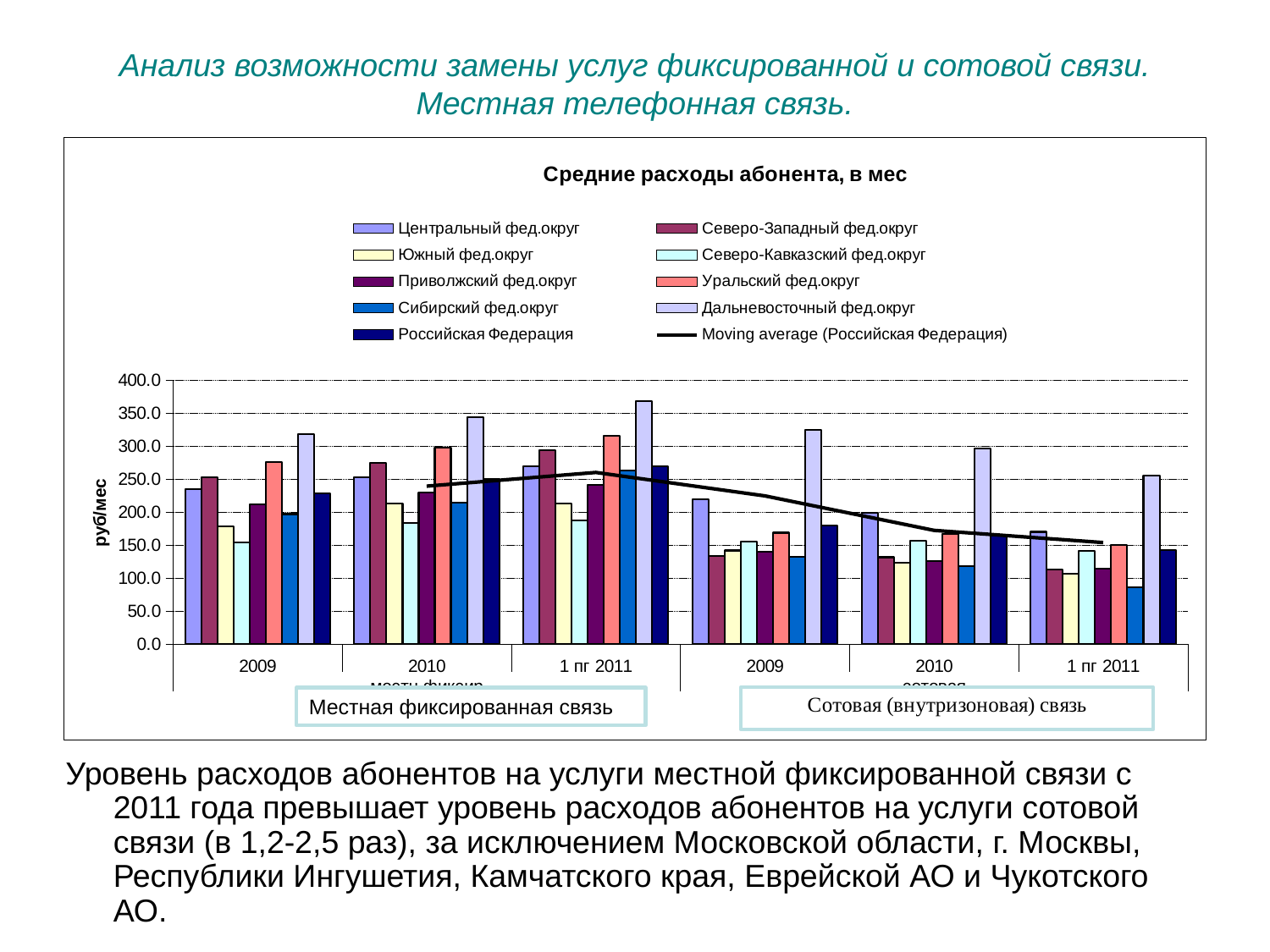
Which federal district has the lowest value in the 1 пг 2011 group for сотовая (внутризоновая) связь? Сибирский фед.округ Is the value for Уральский фед.округ in 1 пг 2011 for местная фиксированная связь greater or less than 300? greater Which federal district has the highest value in the 2009 group for местная фиксированная связь? Дальневосточный фед.округ Does the Moving average (Российская Федерация) line rise or fall from the 1 пг 2011 fixed-line group to the 1 пг 2011 cellular group? fall Is the value for Сибирский фед.округ in 1 пг 2011 for сотовая (внутризоновая) связь greater or less than 100? less In the 2010 group for сотовая (внутризоновая) связь, which is larger: Дальневосточный фед.округ or Центральный фед.округ? Дальневосточный фед.округ How many category groups are shown along the x axis of the chart? 6 How many entries does the legend of the chart list? 10 What is the label of the vertical axis of the chart? руб/мес What kind of chart is shown on the slide? bar chart Is the value for Дальневосточный фед.округ in 1 пг 2011 for местная фиксированная связь greater or less than 350? greater What is the title of the chart? Средние расходы абонента, в мес